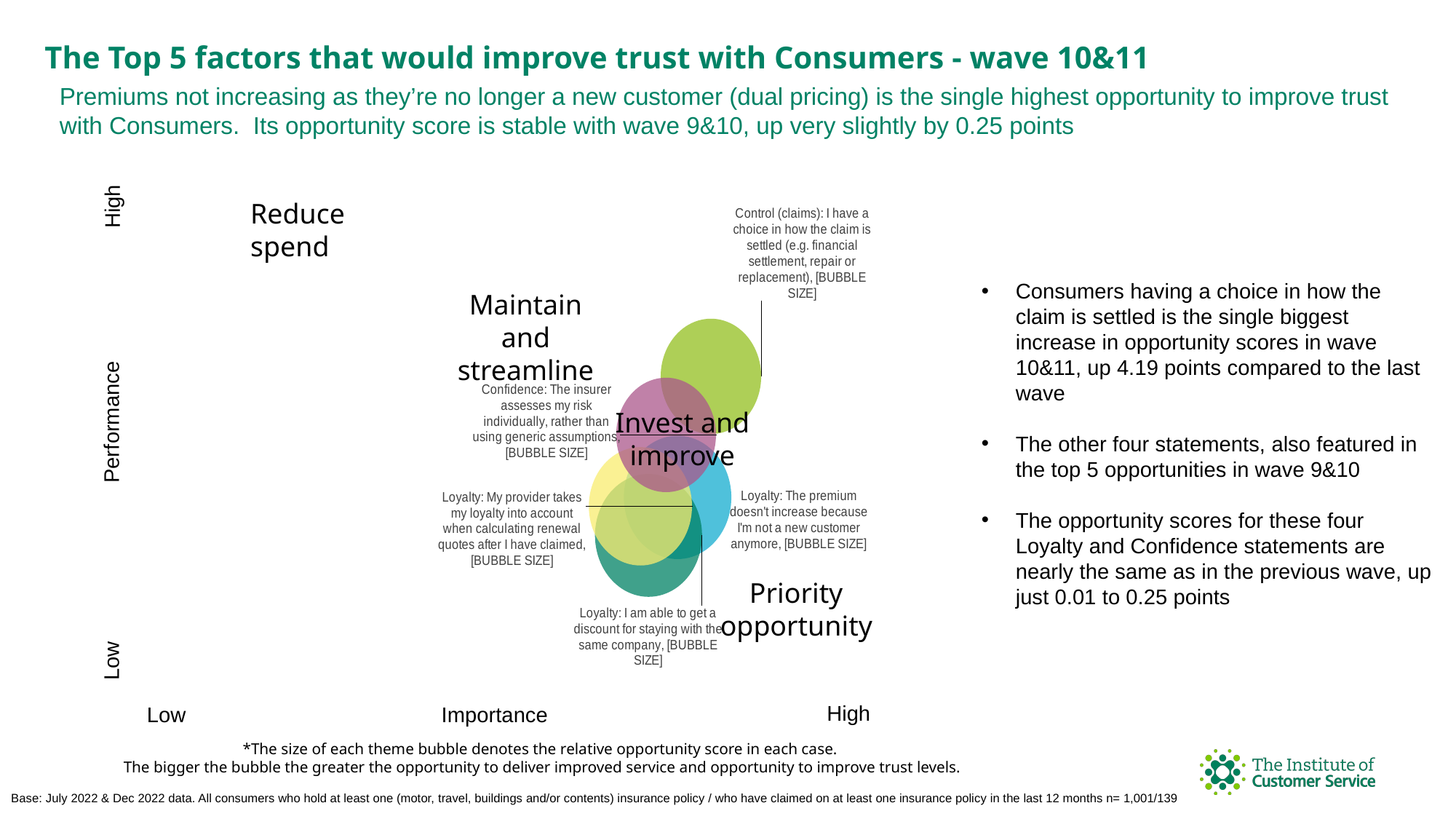
What is the label of the vertical axis of the chart? Performance How many bubbles (statements) are plotted on the chart? 5 Which bubble is higher on the Performance axis: 'Control (claims): I have a choice in how the claim is settled' or 'Loyalty: I am able to get a discount for staying with the same company'? Control (claims): I have a choice in how the claim is settled What kind of chart is shown on the slide? Bubble chart Which bubble is higher on the Performance axis: 'Confidence: The insurer assesses my risk individually' or 'Loyalty: I am able to get a discount for staying with the same company'? Confidence: The insurer assesses my risk individually What is the label of the horizontal axis of the chart? Importance Which statement's bubble is positioned highest on the Performance axis? Control (claims): I have a choice in how the claim is settled (e.g. financial settlement, repair or replacement)